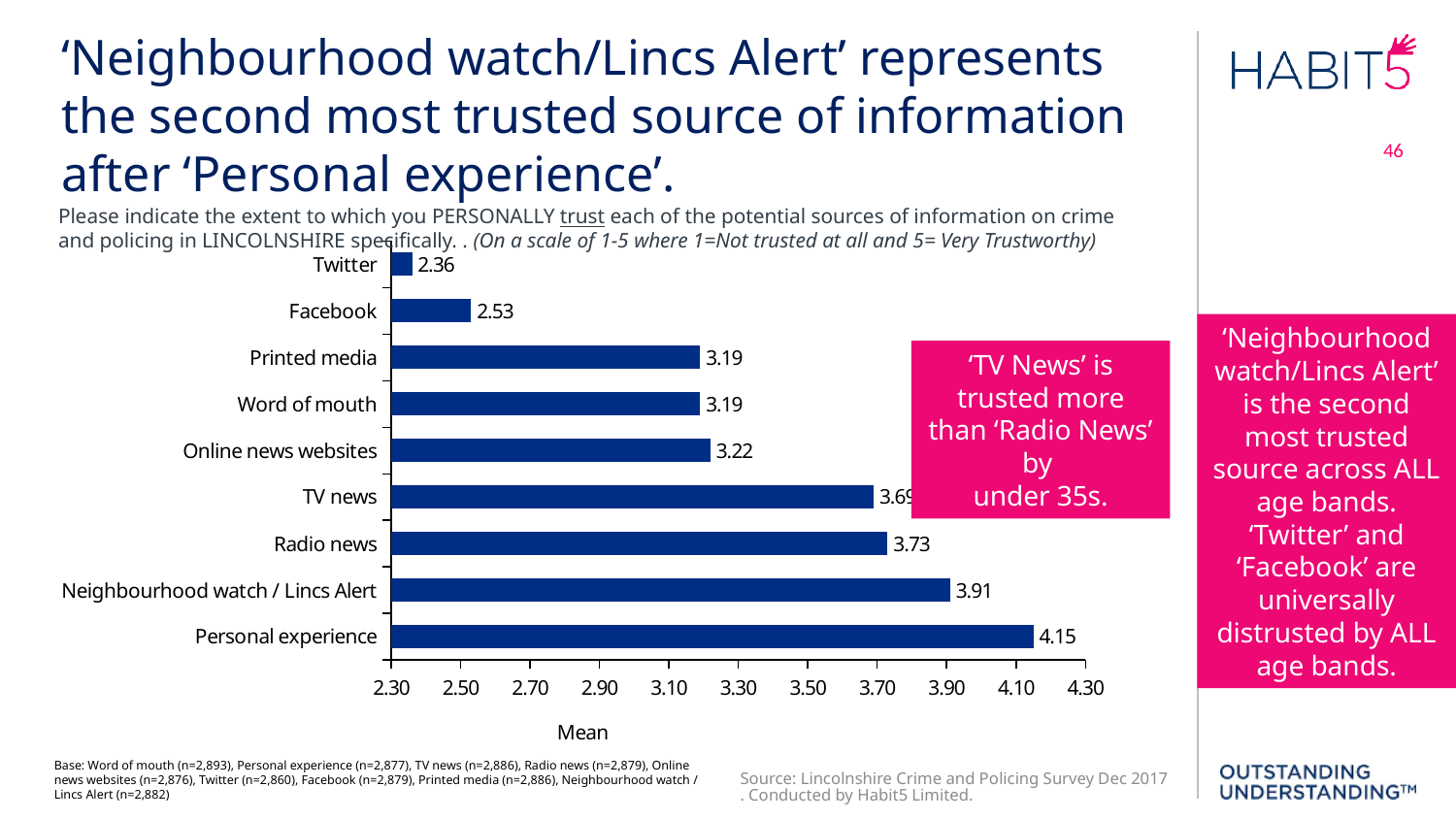
What is the difference between the mean trust scores for Facebook and Twitter? 0.17 What is the mean trust score for Twitter? 2.36 Which source has the highest mean trust score? Personal experience Which has a higher mean trust score, Radio news or Facebook? Radio news What type of chart is shown on the slide? Bar chart What is the mean trust score for Neighbourhood watch / Lincs Alert? 3.91 What is the mean trust score for Online news websites? 3.22 Which source has the lowest mean trust score? Twitter What is the mean trust score for Personal experience? 4.15 What is the difference between the mean trust scores for Personal experience and Neighbourhood watch / Lincs Alert? 0.24 How many sources of information are shown in the chart? 9 Is the mean trust score for TV news greater or less than 3.50? greater